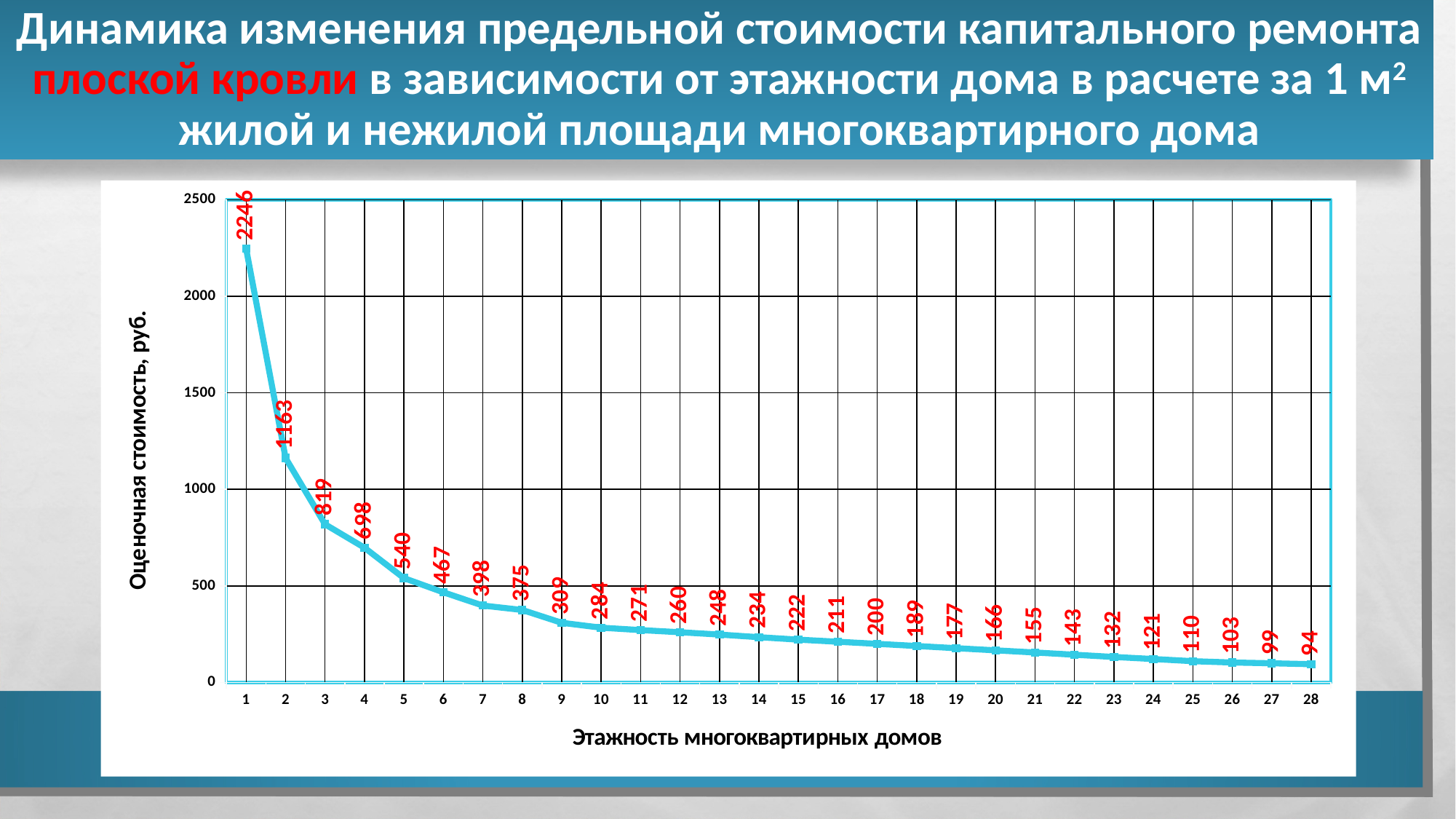
Which number of floors has the highest estimated cost? 1 What kind of chart is shown on the slide? Line chart What is the difference between the values for 1 floor and 2 floors? 1083 What is the estimated cost value for a building with 5 floors? 540 Which number of floors has the lowest estimated cost? 28 Do the values rise or fall as the number of floors increases along the x axis? Fall What is the estimated cost value for a building with 1 floor? 2246 What is the difference between the values for 9 floors and 10 floors? 25 What is the estimated cost value for a building with 28 floors? 94 How many data points are plotted on the chart? 28 Which is larger, the value for 3 floors or the value for 4 floors? 3 floors What is the estimated cost value for a building with 16 floors? 211